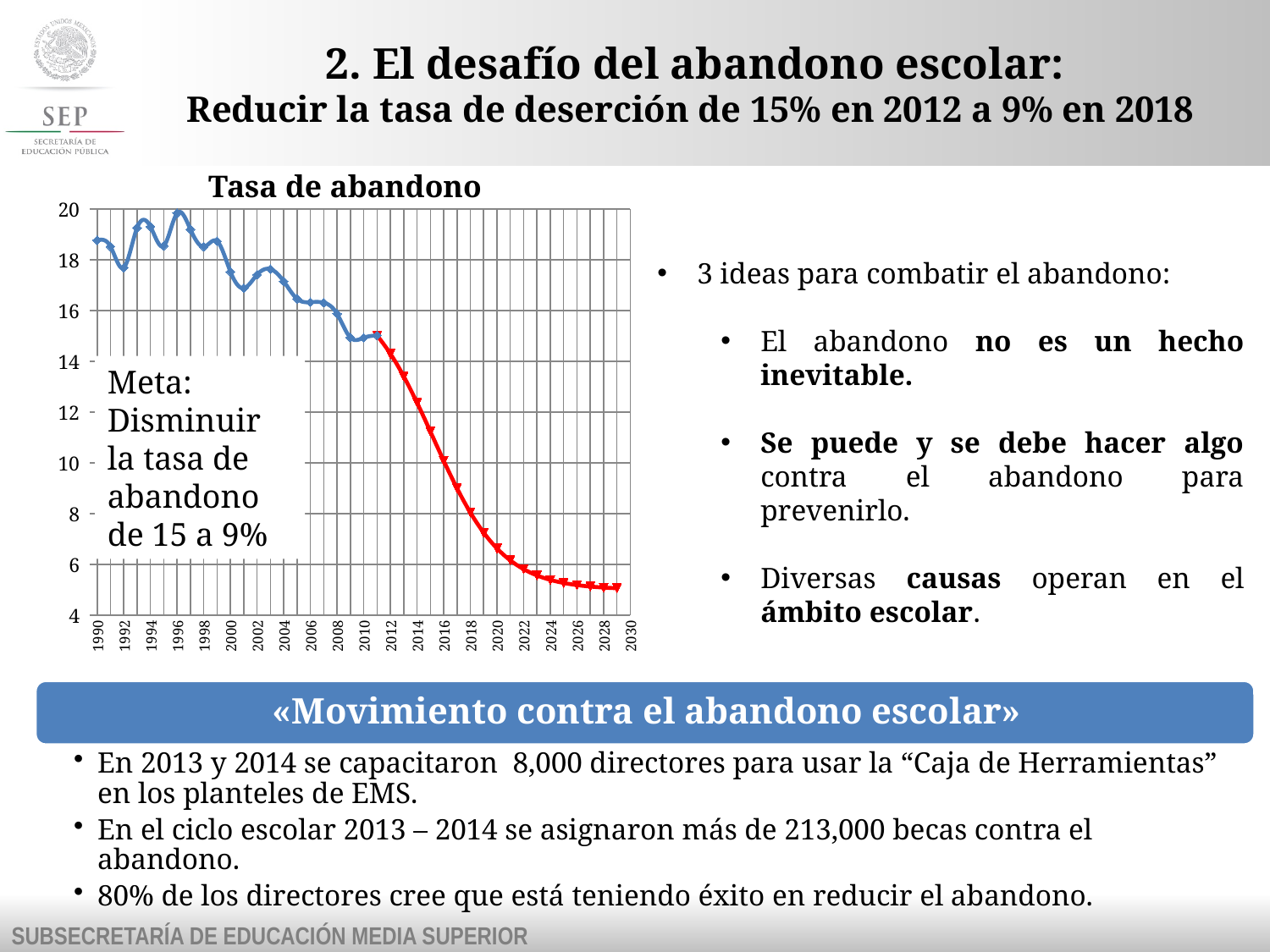
What is the title of the chart? Tasa de abandono Is the value for 2002 greater or less than 16? greater What colour is the projected part of the line after 2012? red Is the value for 1996 larger or smaller than the value for 2010? larger Does the red projected segment of the line rise or fall from 2012 to 2030? fall Is the value for 1996 greater or less than 18? greater What kind of chart is shown on the slide? line chart Is the value for 2016 greater or less than 14? less Which year on the x axis has the lowest value? 2029